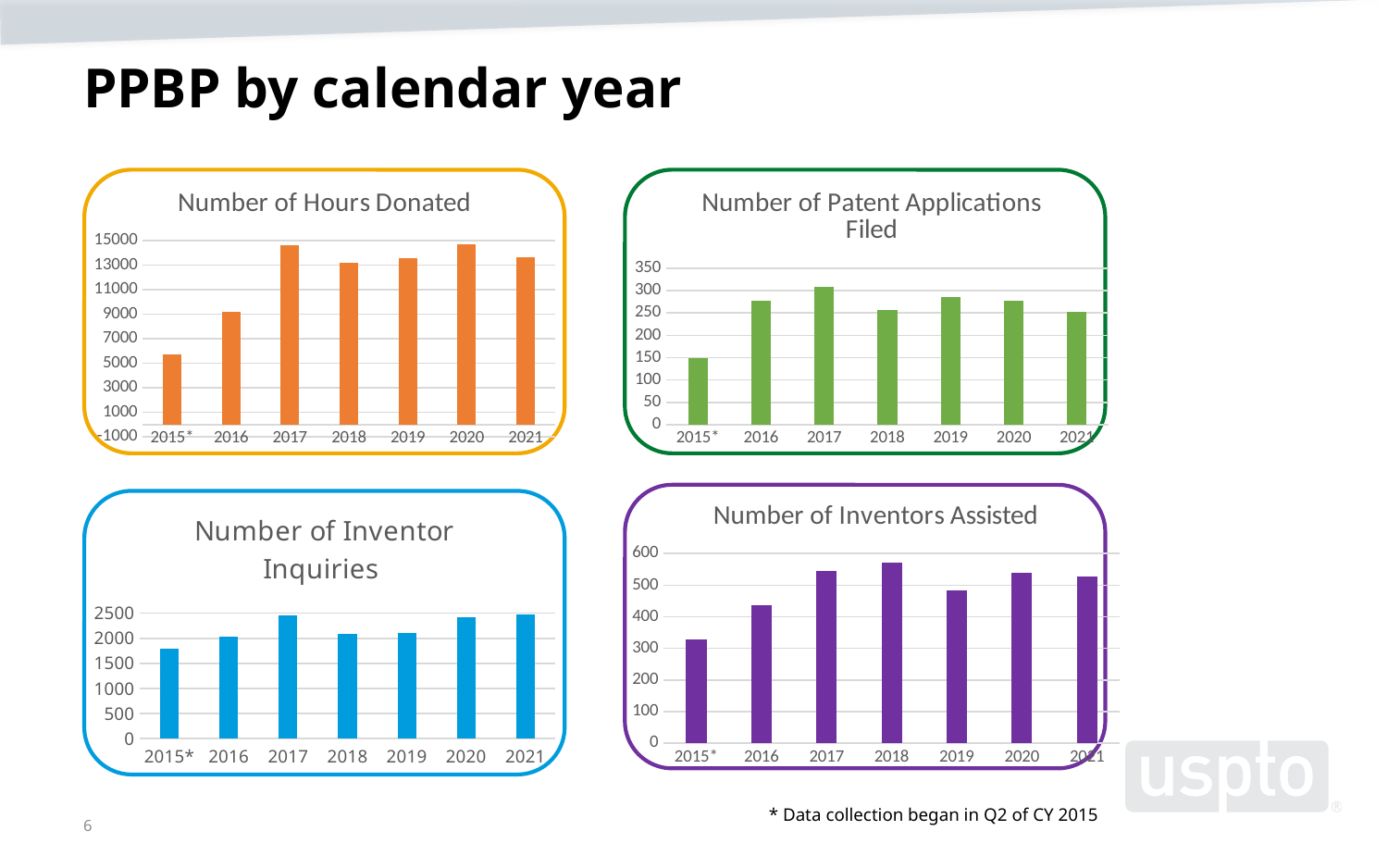
In the Number of Patent Applications Filed chart, which is larger, the value for 2017 or the value for 2018? 2017 In the Number of Hours Donated chart, is the value for 2017 greater or less than 13000? greater In the Number of Inventors Assisted chart, which year has the highest value? 2018 In the Number of Inventor Inquiries chart, is the value for 2017 greater or less than 2000? greater In the Number of Patent Applications Filed chart, is the value for 2015* greater or less than 200? less How many years are shown on the x axis of the Number of Inventors Assisted chart? 7 In the Number of Patent Applications Filed chart, which year has the highest value? 2017 In the Number of Hours Donated chart, which year has the lowest value? 2015* In the Number of Inventor Inquiries chart, which year has the lowest value? 2015* What kind of chart is the Number of Hours Donated chart? bar chart